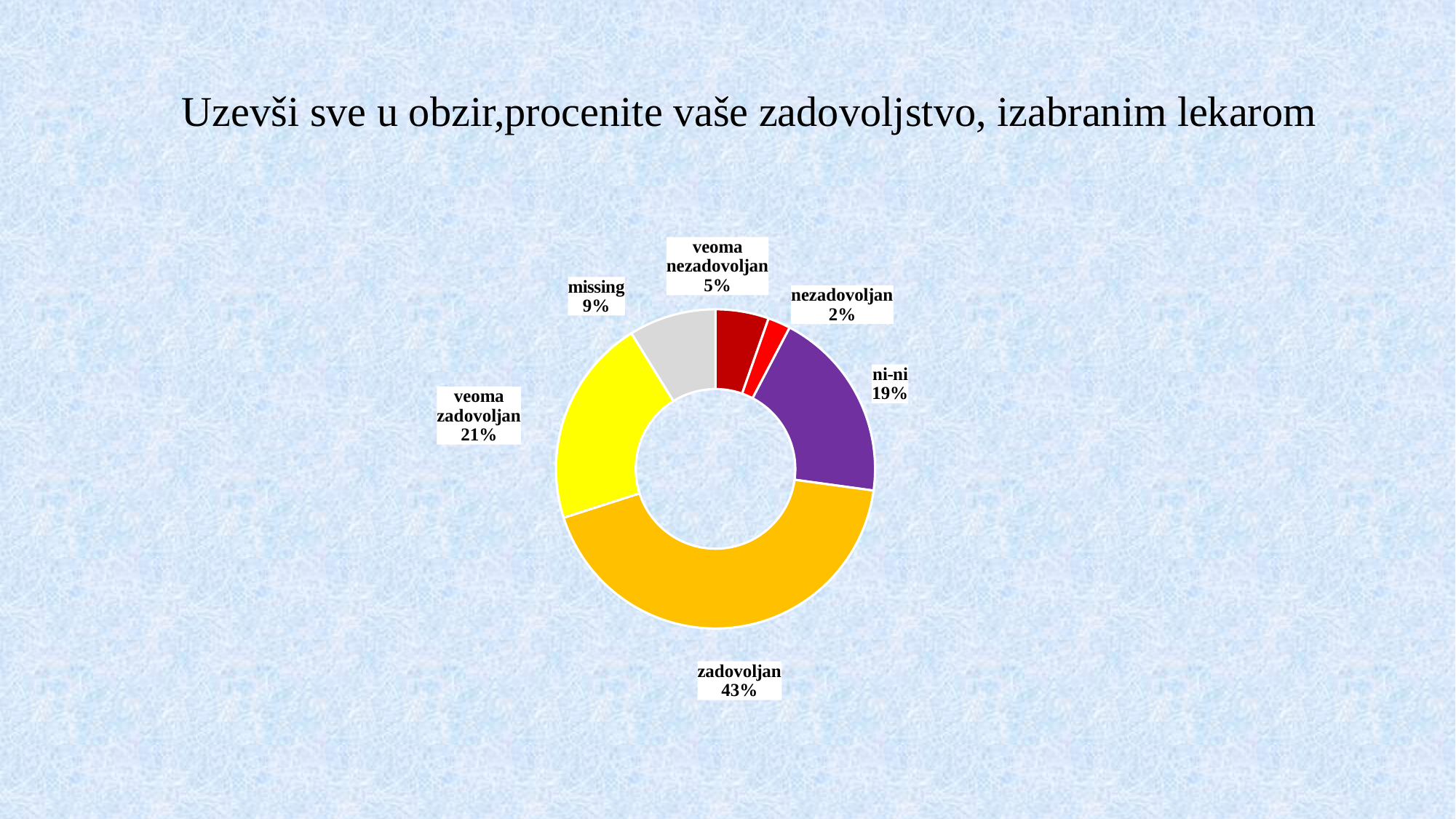
What is the difference in percentage points between "zadovoljan" and "veoma zadovoljan"? 22 What percentage is shown for "ni-ni"? 19% What percentage is shown for "missing"? 9% Which is larger, the share for "ni-ni" or the share for "missing"? ni-ni What share of the chart does the "zadovoljan" slice represent? 43% What kind of chart is shown on the slide? Doughnut (pie) chart What percentage is shown for "veoma zadovoljan"? 21% Which category has the largest share of the chart? zadovoljan How many categories are shown in the chart? 6 What colour is the "zadovoljan" slice? Orange Which category has the smallest share of the chart? nezadovoljan What percentage is shown for "veoma nezadovoljan"? 5%